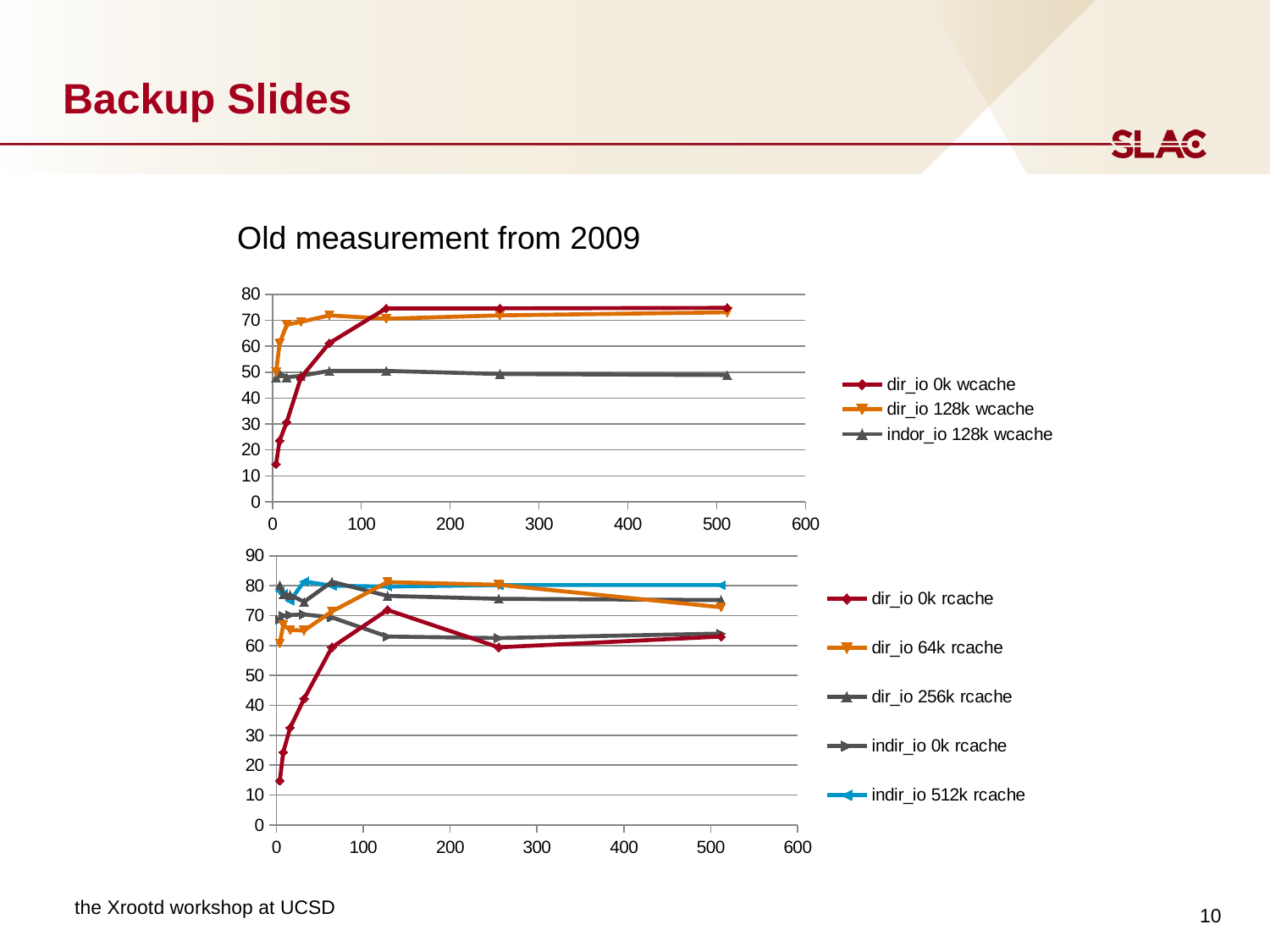
In the top chart, does the dir_io 0k wcache series rise or fall as x increases from 0 to 100? rise In the top chart, is the value of indor_io 128k wcache at x = 500 greater or less than 60? less In the bottom chart, is the value of indir_io 512k rcache at x = 500 greater or less than 70? greater In the bottom chart, at x = 500, which series has the larger value: indir_io 512k rcache or dir_io 0k rcache? indir_io 512k rcache How many series does the legend of the bottom chart list? 5 In the bottom chart, is the value of dir_io 0k rcache at x = 0 greater or less than 20? less In the top chart, at x = 500, which series has the larger value: dir_io 0k wcache or indor_io 128k wcache? dir_io 0k wcache In the bottom chart, which series is drawn in light blue? indir_io 512k rcache How many series does the legend of the top chart list? 3 What kind of chart is the top chart on the slide? line chart